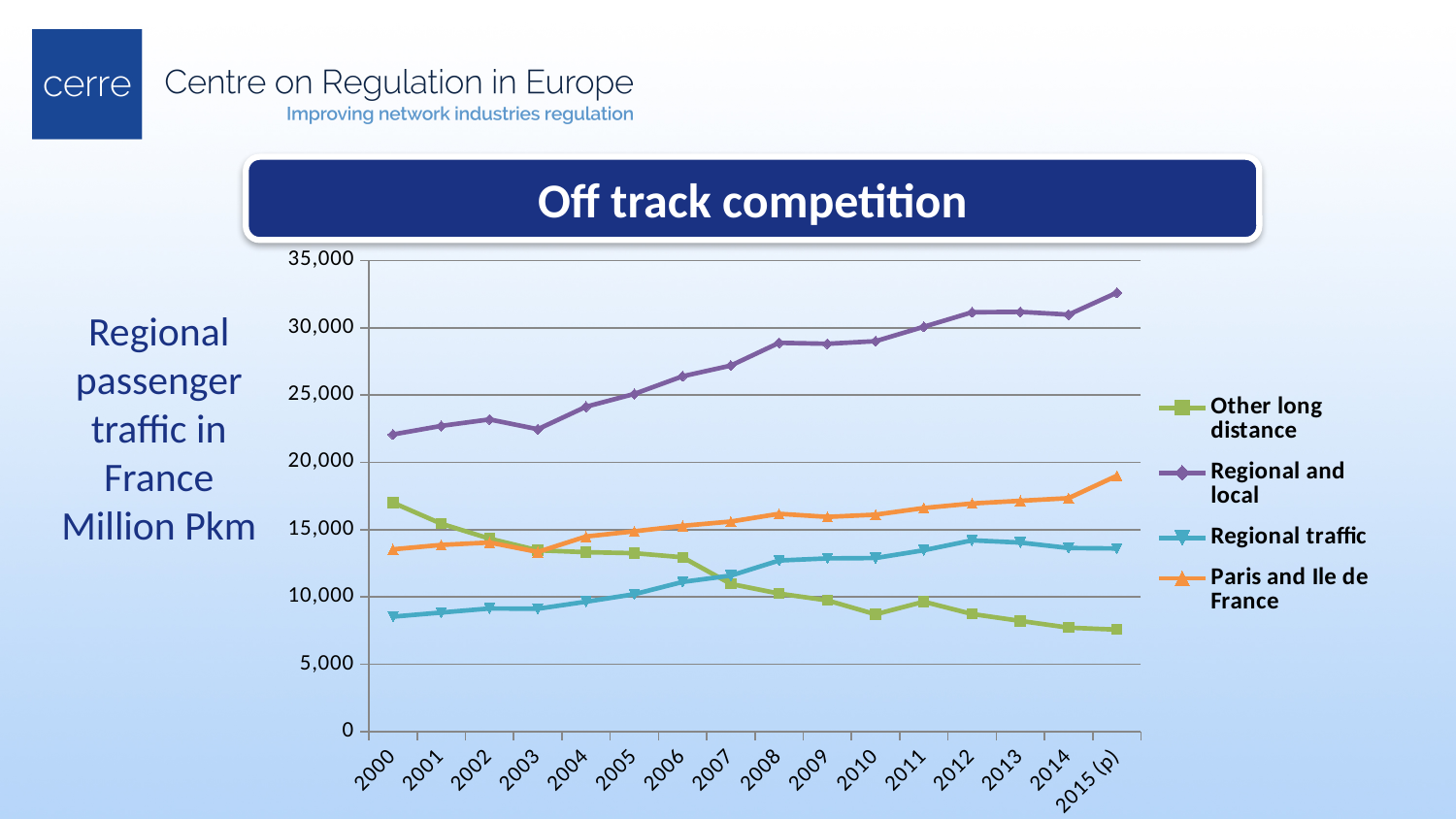
Which series has the lowest value in 2015 (p)? Other long distance Is the value for Regional and local in 2015 (p) greater or less than 30,000? greater How many series does the legend list? 4 Is the value for Other long distance in 2015 (p) greater or less than 10,000? less Which series has the highest value in 2015 (p)? Regional and local In 2000, which is larger: Other long distance or Regional traffic? Other long distance Does the Other long distance series rise or fall from 2000 to 2015 (p)? Fall Is the value for Regional traffic in 2000 greater or less than 10,000? less What is the title shown above the chart? Off track competition Does the Regional and local series rise or fall from 2000 to 2015 (p)? Rise What kind of chart is shown on the slide? Line chart How many years are shown along the x axis? 16